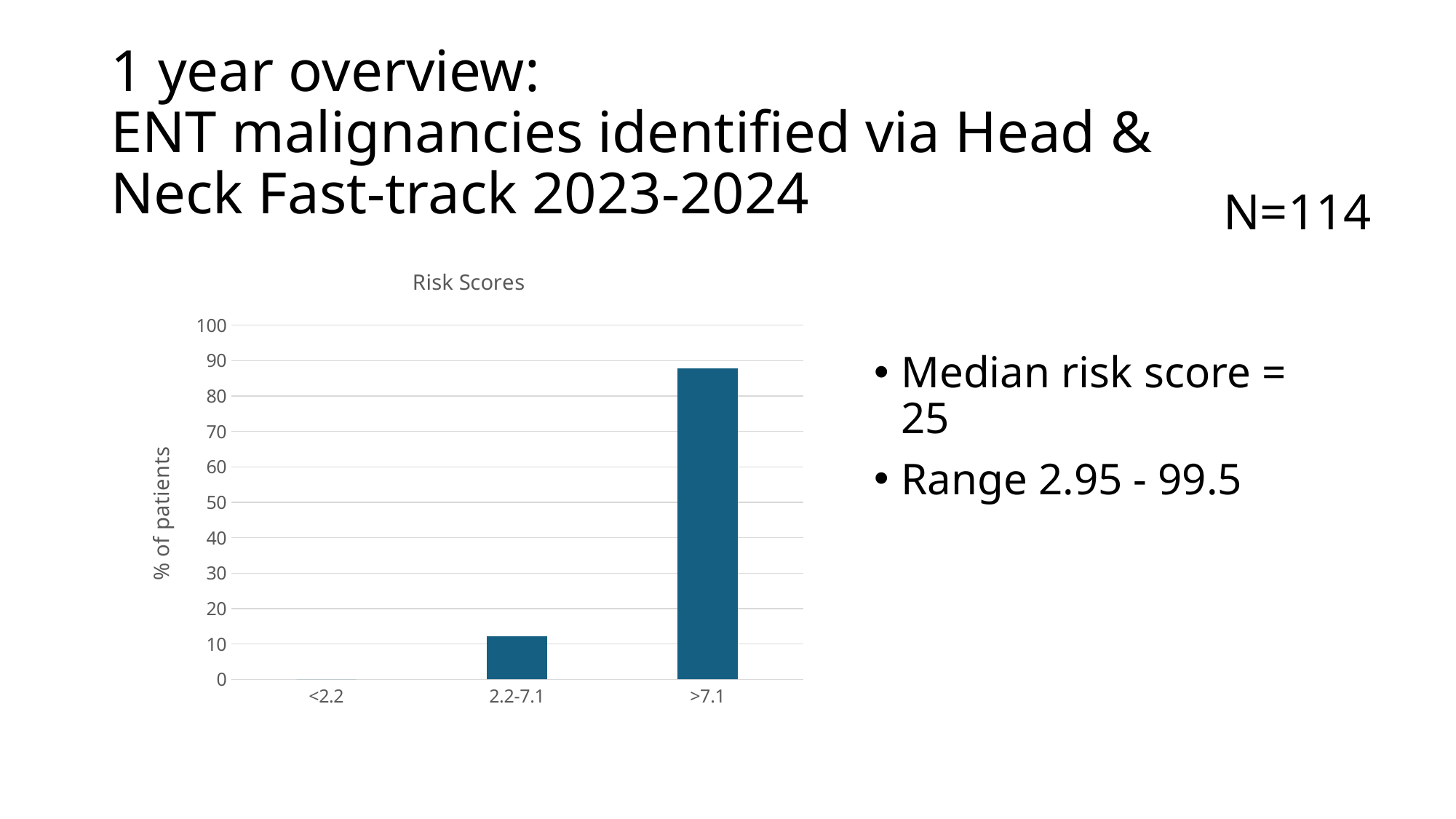
Which has a higher percentage of patients, the 2.2-7.1 category or the >7.1 category? >7.1 Do the values rise or fall moving from left to right along the x axis of the chart? rise Which risk score category has the lowest percentage of patients? <2.2 What kind of chart is shown on the slide? bar chart Is the percentage of patients in the >7.1 category greater or less than 80? greater What is the title of the chart? Risk Scores Which risk score category has the highest percentage of patients? >7.1 What is the label on the vertical axis of the chart? % of patients Is the percentage of patients in the >7.1 category greater or less than 50? greater Is the percentage of patients in the 2.2-7.1 category greater or less than 30? less How many risk score categories are shown on the x axis of the chart? 3